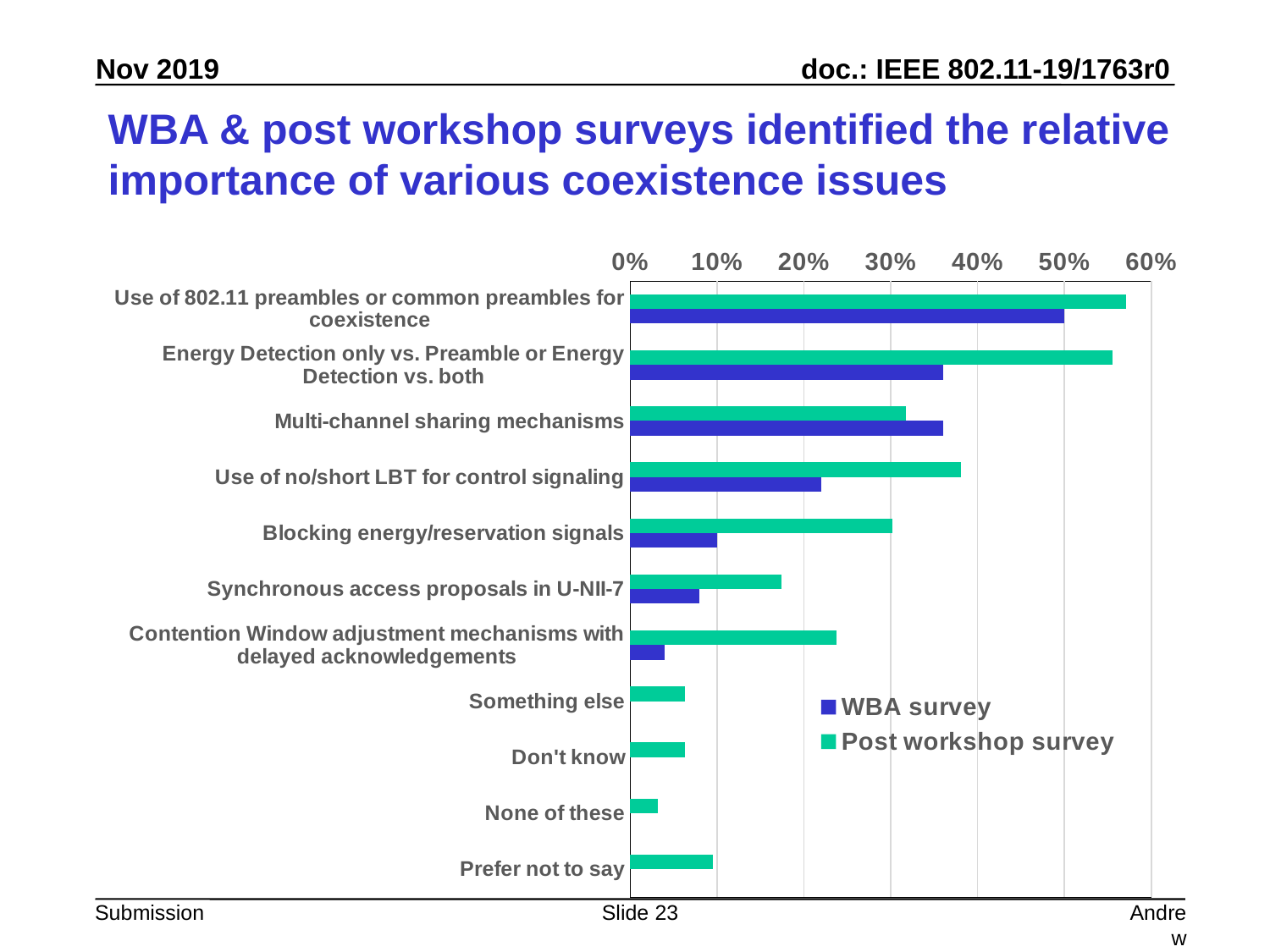
What colour represents the WBA survey series in the chart? Blue How many categories are plotted on the chart? 11 Is the Post workshop survey value for Blocking energy/reservation signals greater or less than 20%? greater Which category has the highest value in the WBA survey series? Use of 802.11 preambles or common preambles for coexistence What kind of chart is shown on the slide? Bar chart For Use of no/short LBT for control signaling, which series has the larger value, WBA survey or Post workshop survey? Post workshop survey How many series does the legend list? 2 Is the Post workshop survey value for Synchronous access proposals in U-NII-7 greater or less than 20%? less Is the WBA survey value for Contention Window adjustment mechanisms with delayed acknowledgements greater or less than 10%? less Which category has the lowest value in the Post workshop survey series? None of these For Energy Detection only vs. Preamble or Energy Detection vs. both, which series has the larger value, WBA survey or Post workshop survey? Post workshop survey